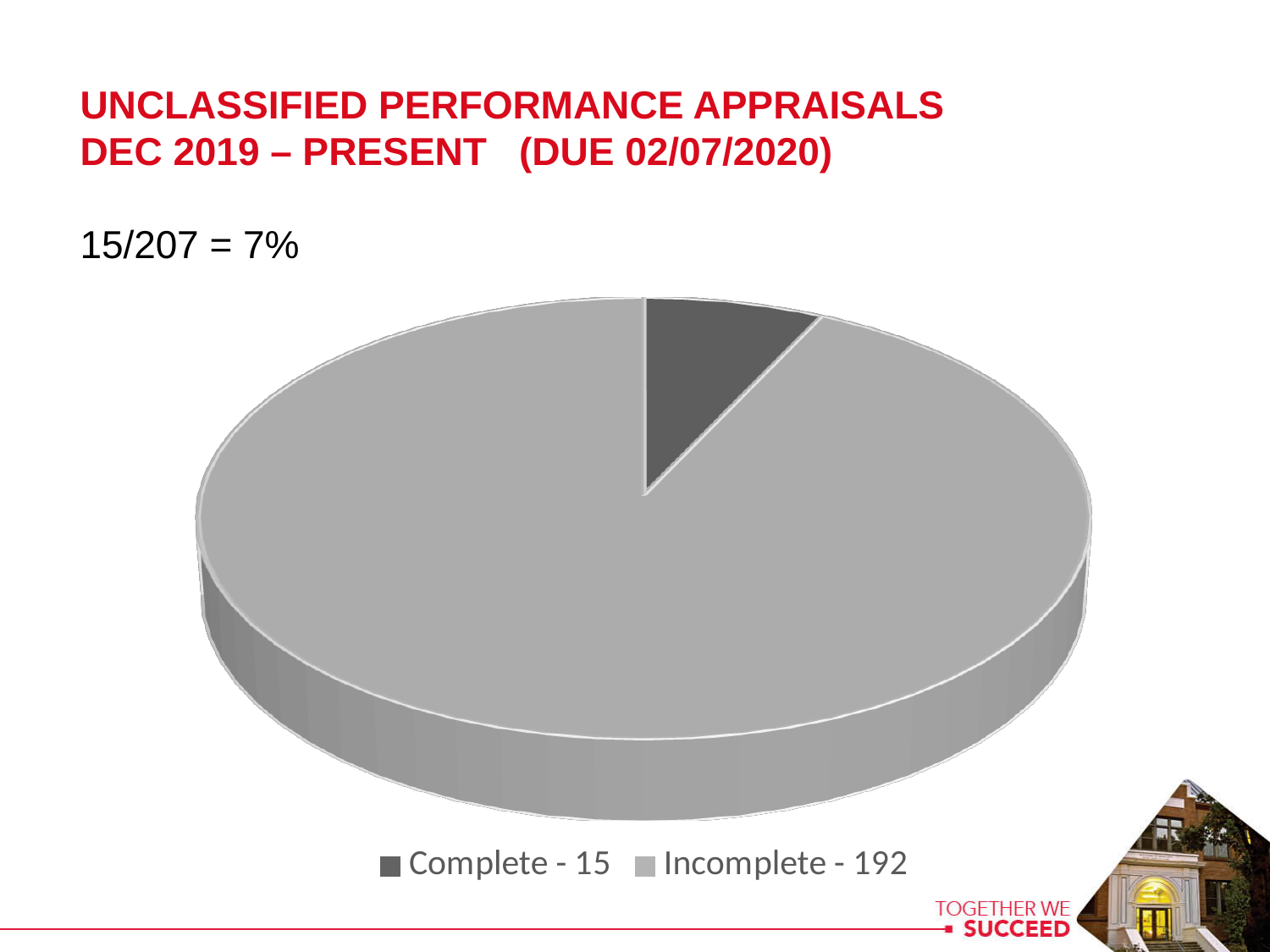
Which slice is the smallest? Complete Which slice is shown in the darker grey colour? Complete What is the difference between Incomplete and Complete? 177 How many entries does the legend list? 2 What is the total of Complete and Incomplete? 207 Which is larger, Complete or Incomplete? Incomplete Which slice is the largest? Incomplete How many slices does the pie chart have? 2 What is the value for Complete? 15 What is the value for Incomplete? 192 What share of the pie does Complete represent, as stated on the slide? 7% What kind of chart is shown on the slide? pie chart